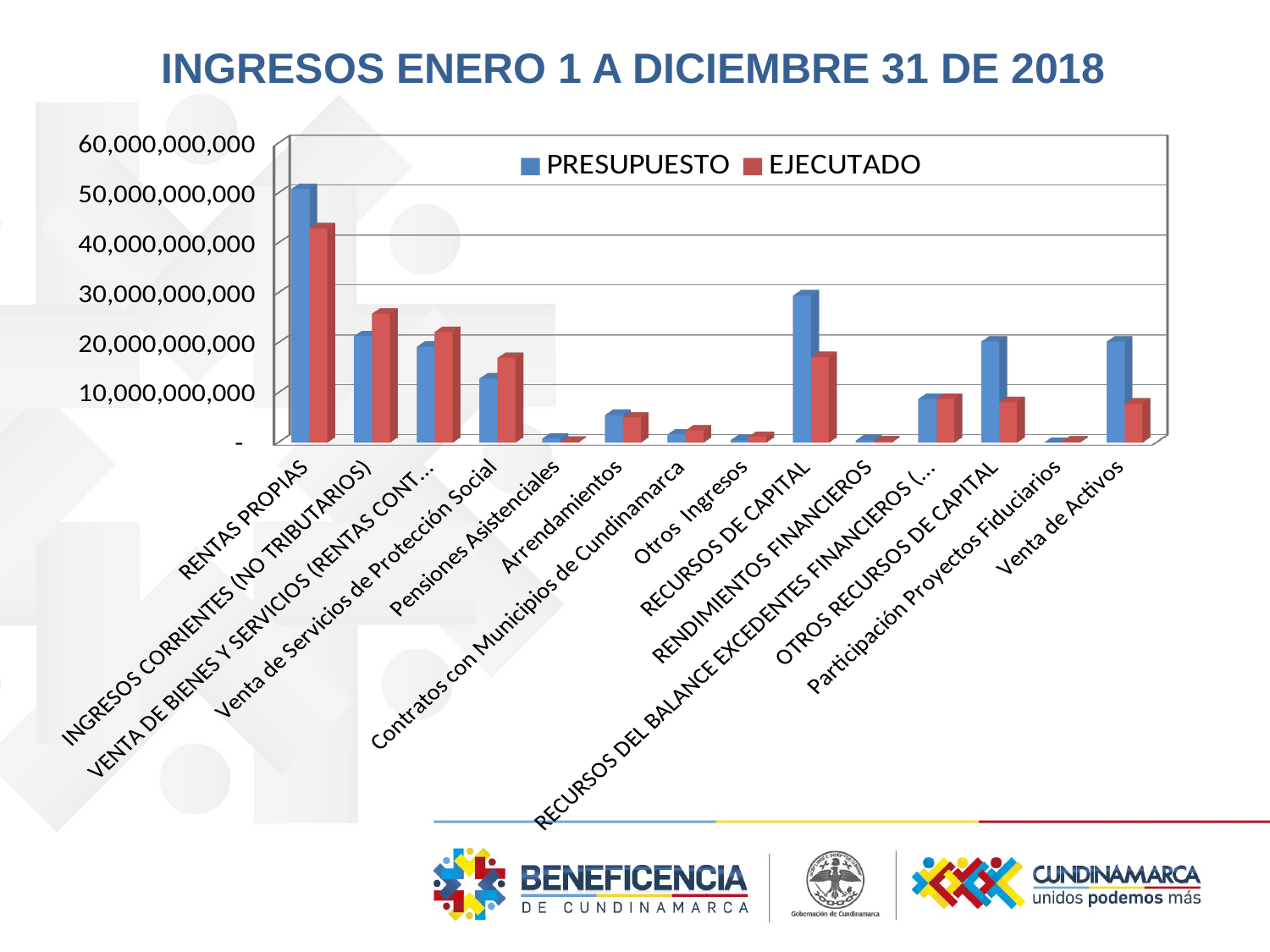
For RECURSOS DE CAPITAL, which is larger, PRESUPUESTO or EJECUTADO? PRESUPUESTO Is the EJECUTADO value for RECURSOS DE CAPITAL greater or less than 20,000,000,000? less How many categories are shown on the x axis? 14 Which category has the highest EJECUTADO value? RENTAS PROPIAS How many series does the legend list? 2 For INGRESOS CORRIENTES (NO TRIBUTARIOS), which is larger, PRESUPUESTO or EJECUTADO? EJECUTADO Which colour represents the EJECUTADO series? red Is the PRESUPUESTO value for RECURSOS DE CAPITAL greater or less than 20,000,000,000? greater Which category has the highest PRESUPUESTO value? RENTAS PROPIAS What is the title of the slide? INGRESOS ENERO 1 A DICIEMBRE 31 DE 2018 What kind of chart is shown on the slide? bar chart